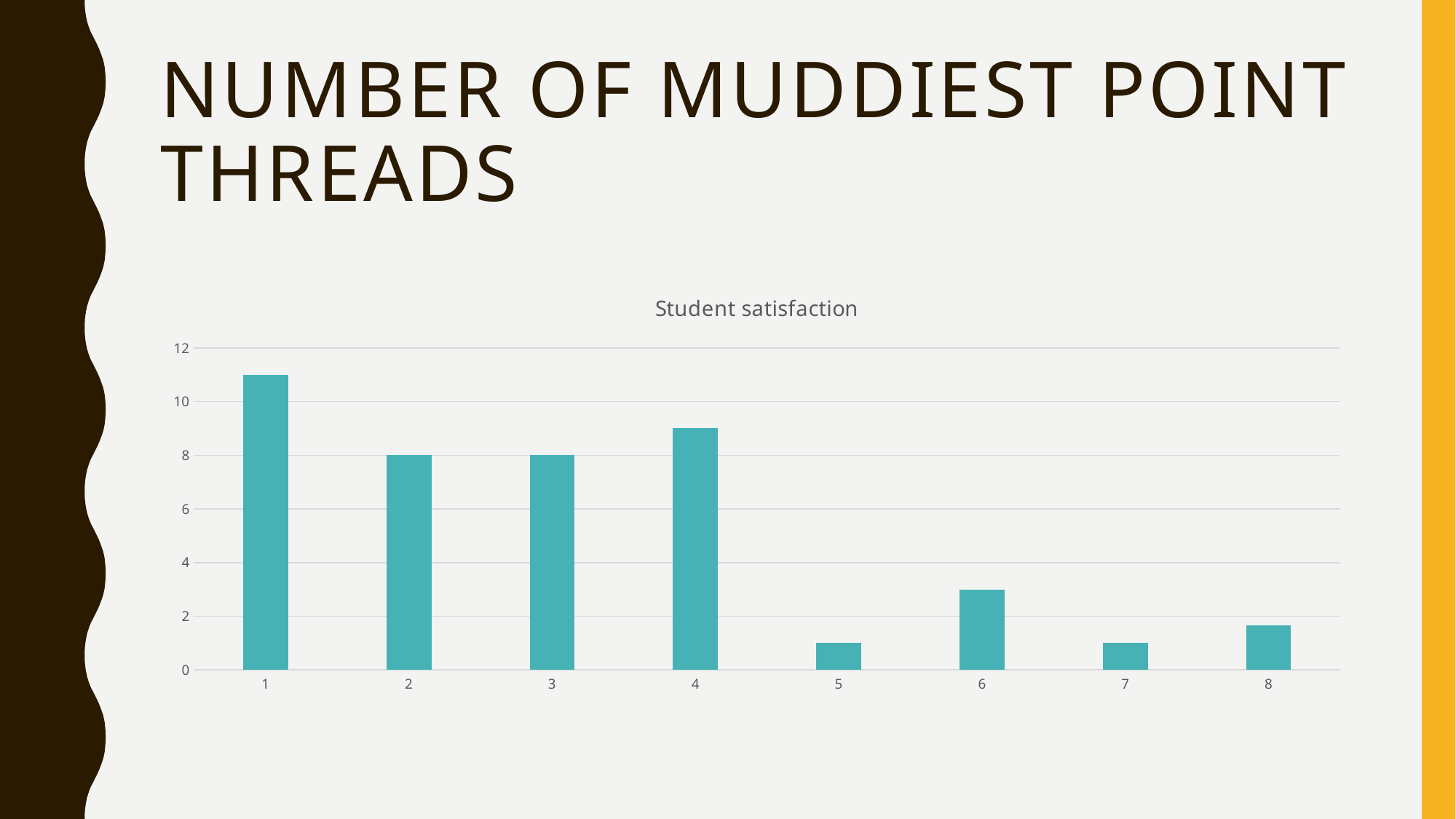
Is the value for category 4 greater or less than 8? greater Do the values generally rise or fall from category 1 to category 8? fall What is the value for category 3? 8 What kind of chart is shown on the slide? bar chart What is the title of the chart? Student satisfaction Is the value for category 5 greater or less than 2? less Which category has the highest value? 1 Which is larger, the value for category 4 or the value for category 2? category 4 How many categories are plotted on the x axis? 8 What is the value for category 2? 8 Is the value for category 1 greater or less than 10? greater